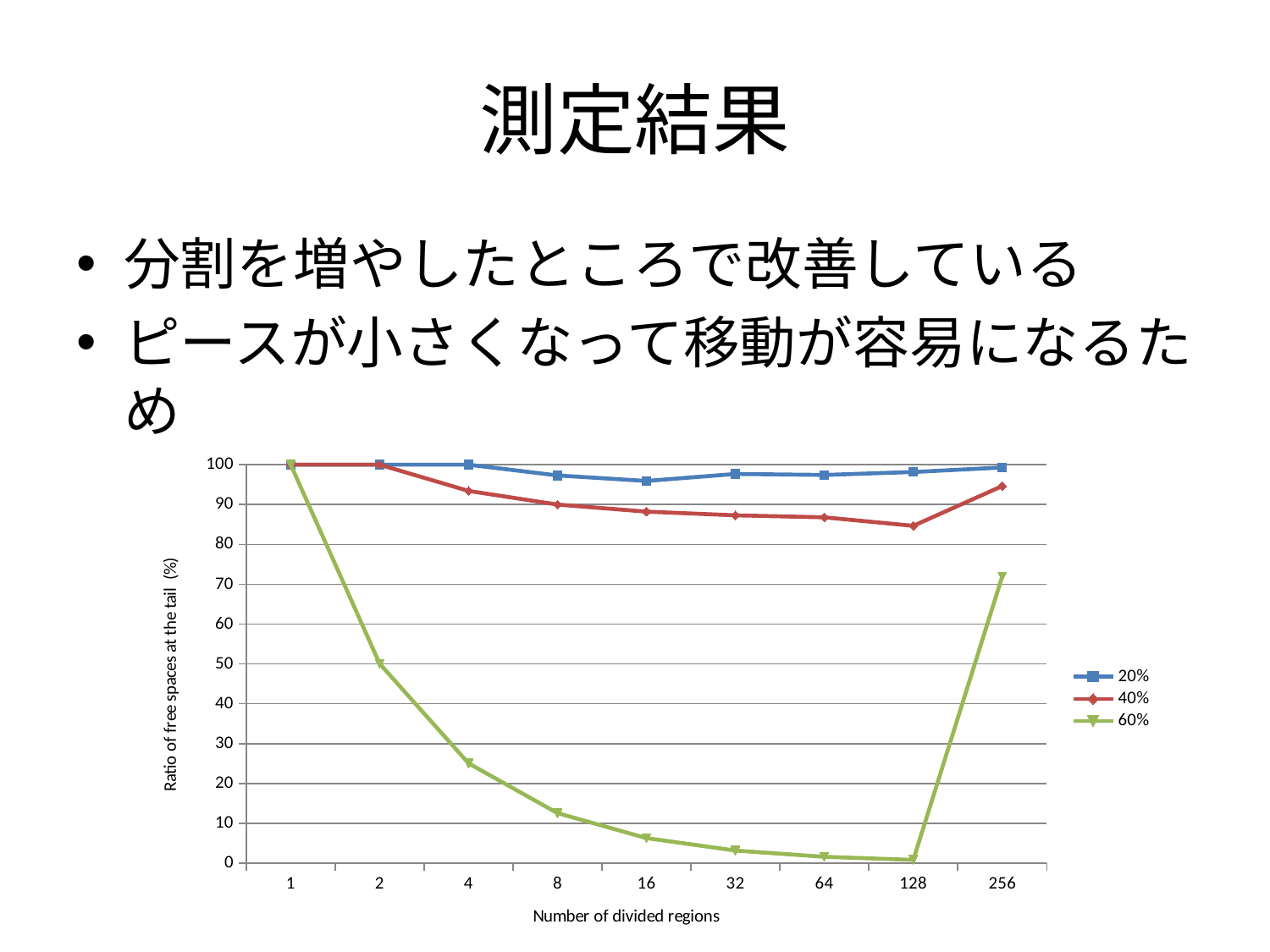
At 256 divided regions, which series has the larger value, 20% or 60%? 20% Is the value of the 60% series at 256 divided regions greater or less than 60? greater How many values of Number of divided regions are plotted along the x axis? 9 At which number of divided regions does the 60% series reach its lowest value? 128 How many series does the legend list? 3 What is the value of the 60% series at 1 divided region? 100 At which number of divided regions does the 40% series reach its lowest value? 128 Is the value of the 60% series at 16 divided regions greater or less than 10? less Is the value of the 40% series at 128 divided regions greater or less than 90? less What kind of chart is shown on the slide? line chart What is the value of the 20% series at 2 divided regions? 100 Does the 60% series rise or fall from 1 to 128 divided regions? fall